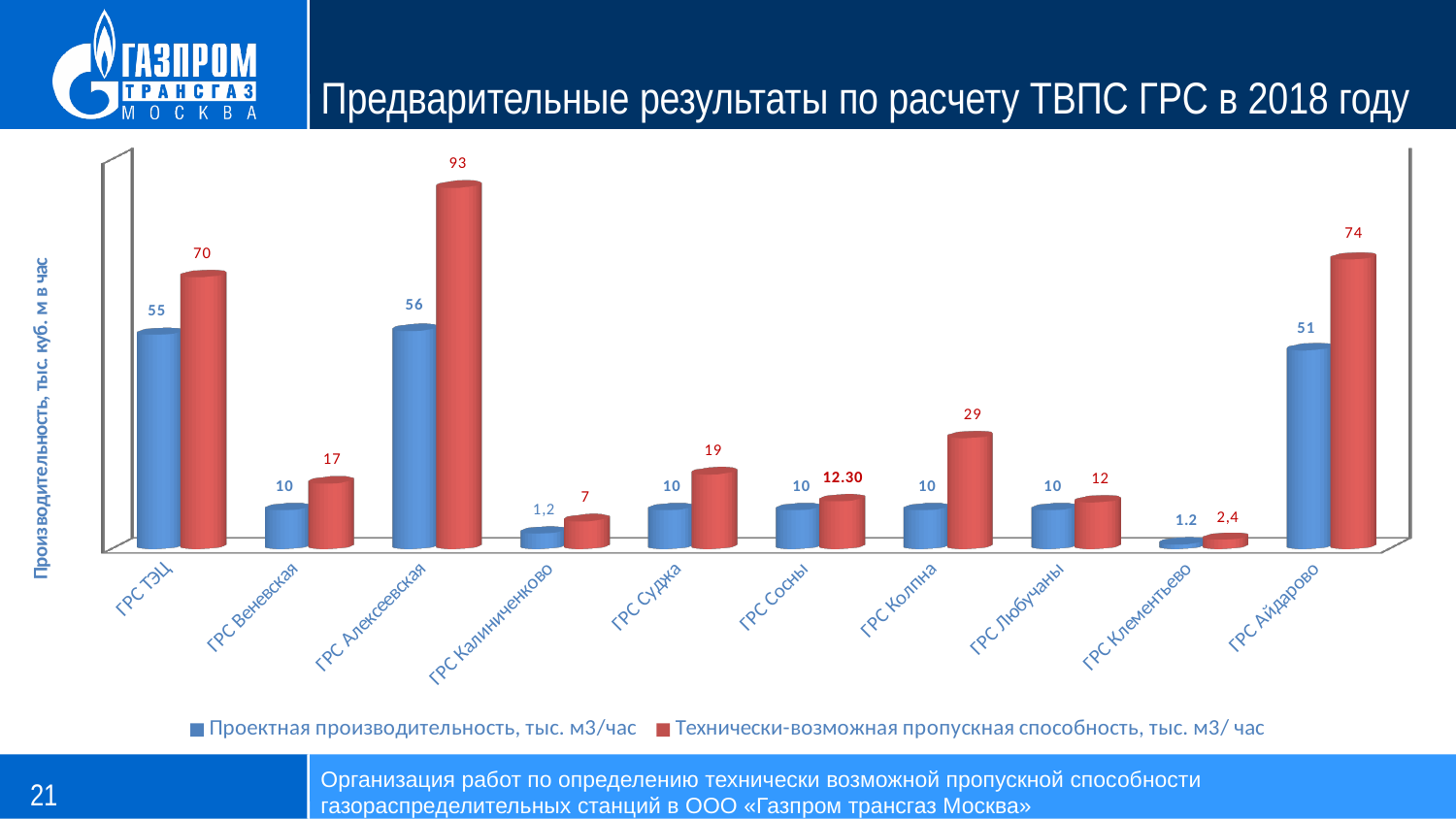
Which is larger: the Технически-возможная пропускная способность value for ГРС Колпна or for ГРС Суджа? ГРС Колпна What kind of chart is shown on the slide? Bar chart Which category has the lowest Технически-возможная пропускная способность value? ГРС Клементьево What is the Технически-возможная пропускная способность value for ГРС Алексеевская? 93 What is the difference between the Технически-возможная пропускная способность and Проектная производительность values for ГРС Айдарово? 23 What is the Проектная производительность value for ГРС Калиниченково? 1,2 Which category has the highest Технически-возможная пропускная способность value? ГРС Алексеевская How many categories are shown on the x axis? 10 What is the title of the slide containing the chart? Предварительные результаты по расчету ТВПС ГРС в 2018 году What is the Проектная производительность value for ГРС ТЭЦ? 55 What is the Технически-возможная пропускная способность value for ГРС Сосны? 12.30 How many series does the legend list? 2